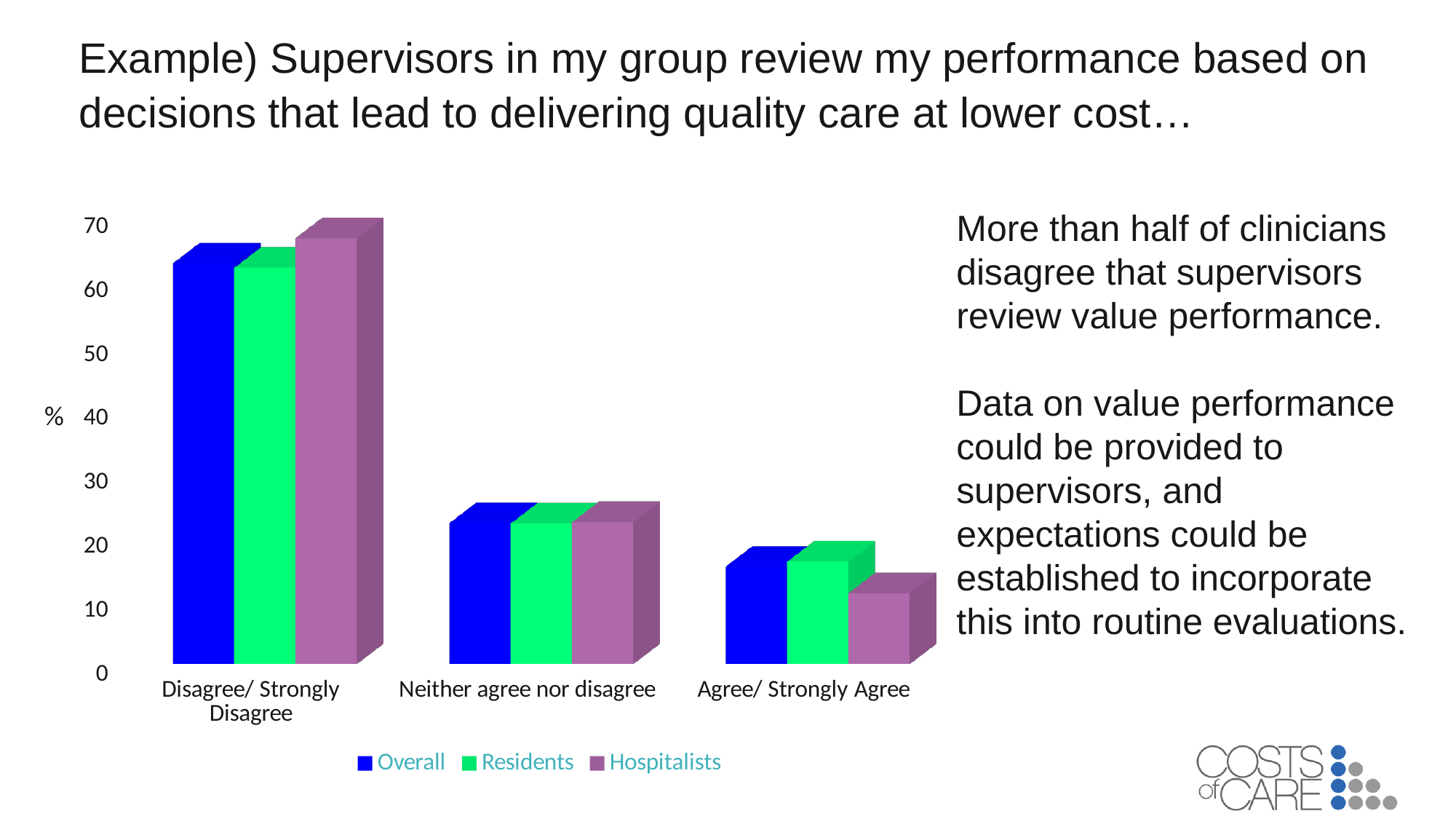
What are the three series listed in the chart's legend? Overall, Residents, Hospitalists Is the Overall value for Neither agree nor disagree greater or less than 30? less For the Overall series, which category has the highest value? Disagree/ Strongly Disagree What label is shown on the vertical axis of the chart? % What kind of chart is shown on the slide? bar chart Do the Overall values rise or fall moving from Disagree/ Strongly Disagree to Agree/ Strongly Agree along the x axis? fall In the Agree/ Strongly Agree category, which is larger: the Overall value or the Hospitalists value? Overall How many categories are shown on the x axis of the chart? 3 How many series does the chart's legend list? 3 For the Hospitalists series, which category has the lowest value? Agree/ Strongly Agree Is the Overall value for Disagree/ Strongly Disagree greater or less than 60? greater Is the Hospitalists value for Agree/ Strongly Agree greater or less than 20? less